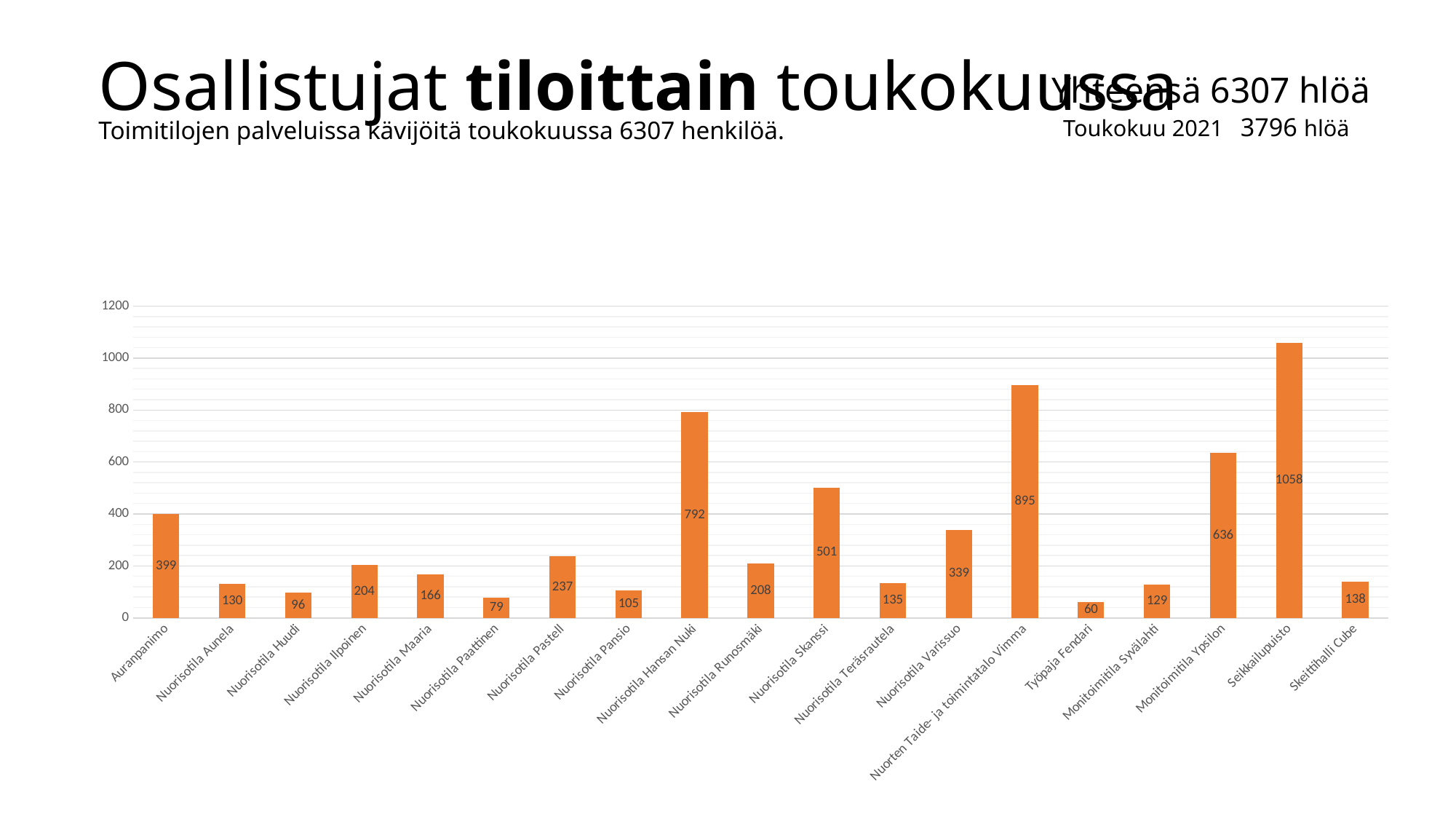
Which category has the highest value? Seikkailupuisto What is the value for Monitoimitila Ypsilon? 636 How many categories are shown on the x axis? 19 Which is larger, the value for Nuorisotila Skanssi or the value for Nuorisotila Varissuo? Nuorisotila Skanssi What is the value for Työpaja Fendari? 60 What is the value for Nuorisotila Paattinen? 79 What kind of chart is shown on the slide? bar chart Is the value for Auranpanimo greater or less than 200? greater What is the value for Seikkailupuisto? 1058 Which category has the lowest value? Työpaja Fendari What is the difference between the values for Nuorten Taide- ja toimintatalo Vimma and Nuorisotila Hansan Nuki? 103 What is the value for Nuorisotila Hansan Nuki? 792